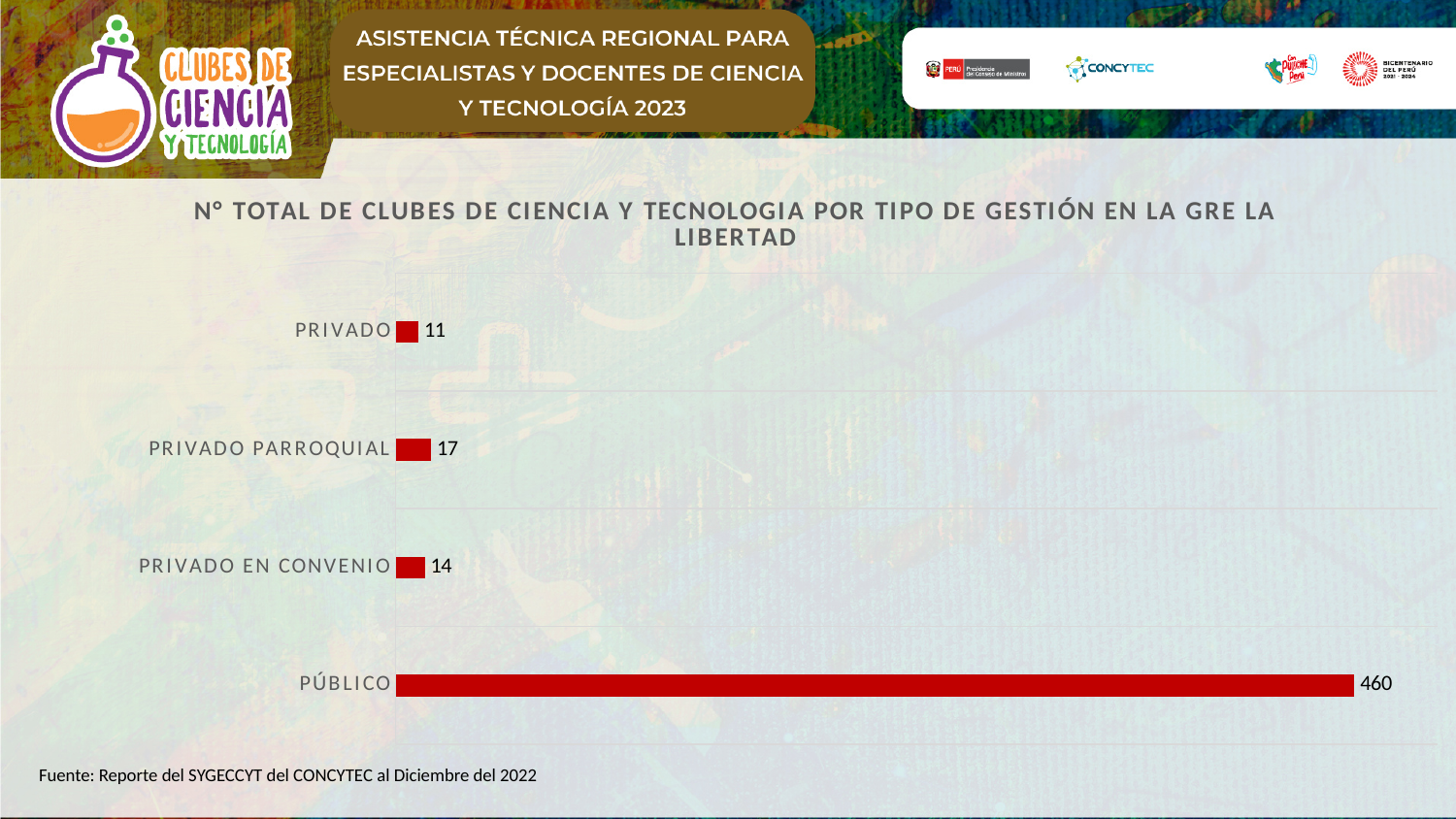
What kind of chart is shown on the slide? Bar chart What is the title of the chart? N° TOTAL DE CLUBES DE CIENCIA Y TECNOLOGIA POR TIPO DE GESTIÓN EN LA GRE LA LIBERTAD What is the value for PÚBLICO? 460 What is the difference between the values for PRIVADO PARROQUIAL and PRIVADO? 6 Which category has the lowest value? PRIVADO What is the value for PRIVADO PARROQUIAL? 17 How many categories are shown in the chart? 4 What is the value for PRIVADO? 11 What is the value for PRIVADO EN CONVENIO? 14 Which is larger, the value for PRIVADO EN CONVENIO or the value for PRIVADO? PRIVADO EN CONVENIO What is the difference between the values for PÚBLICO and PRIVADO PARROQUIAL? 443 Which category has the highest value? PÚBLICO